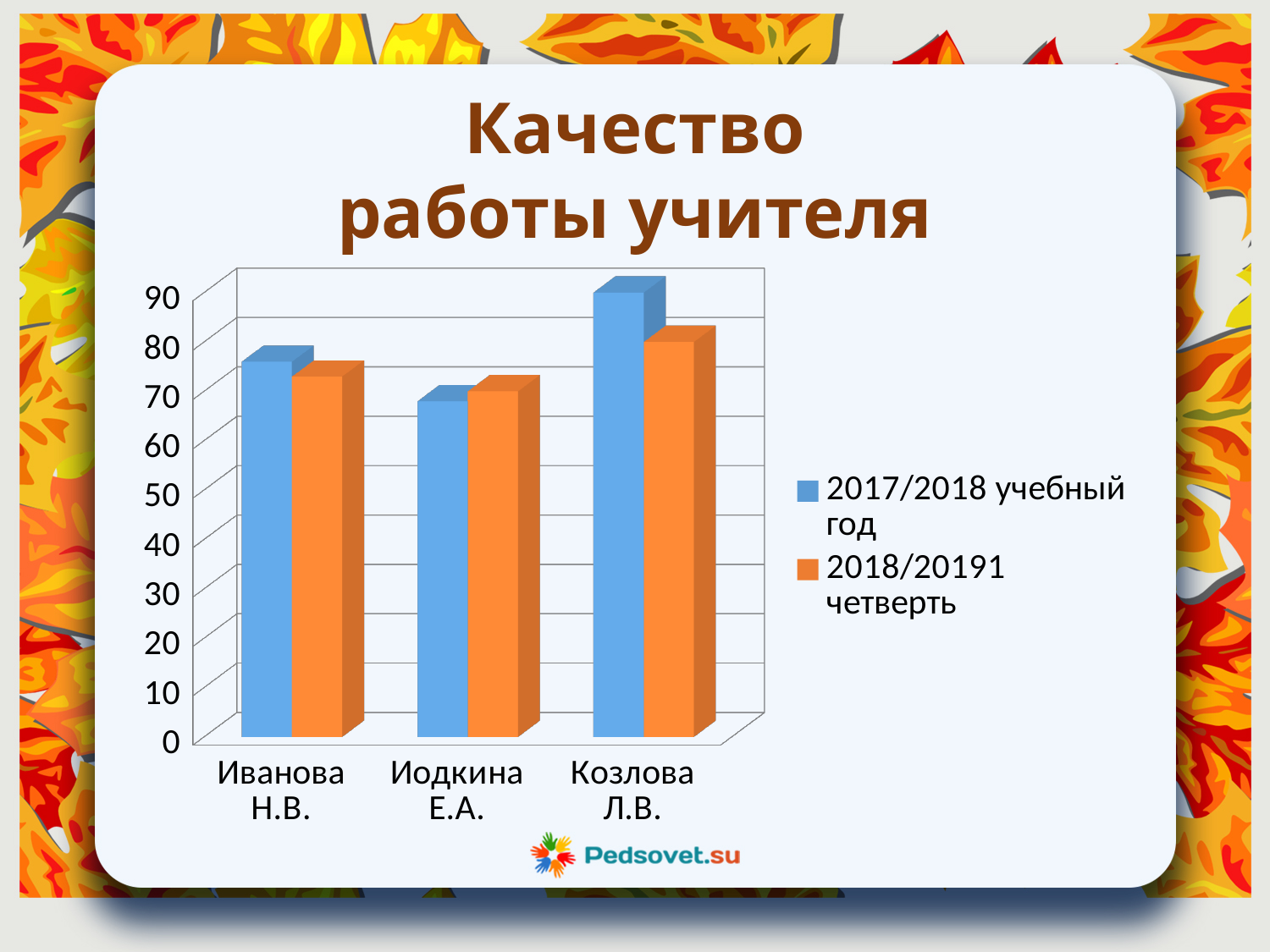
Is the 2018/2019 1 четверть value for Иодкина Е.А. greater or less than 80? less What is the title of the chart on the slide? Качество работы учителя Is the 2017/2018 учебный год value for Козлова Л.В. greater or less than 80? greater Which teacher has the lowest value for the 2017/2018 учебный год series? Иодкина Е.А. Which teacher has the highest value for the 2018/2019 1 четверть series? Козлова Л.В. For the 2017/2018 учебный год series, which is larger: Иванова Н.В. or Иодкина Е.А.? Иванова Н.В. How many teachers (categories) are shown on the x axis? 3 Which teacher has the highest value for the 2017/2018 учебный год series? Козлова Л.В. What kind of chart is shown on the slide? bar chart Is the 2017/2018 учебный год value for Иванова Н.В. greater or less than 70? greater For Козлова Л.В., which series has the larger value: 2017/2018 учебный год or 2018/2019 1 четверть? 2017/2018 учебный год How many series does the legend list? 2